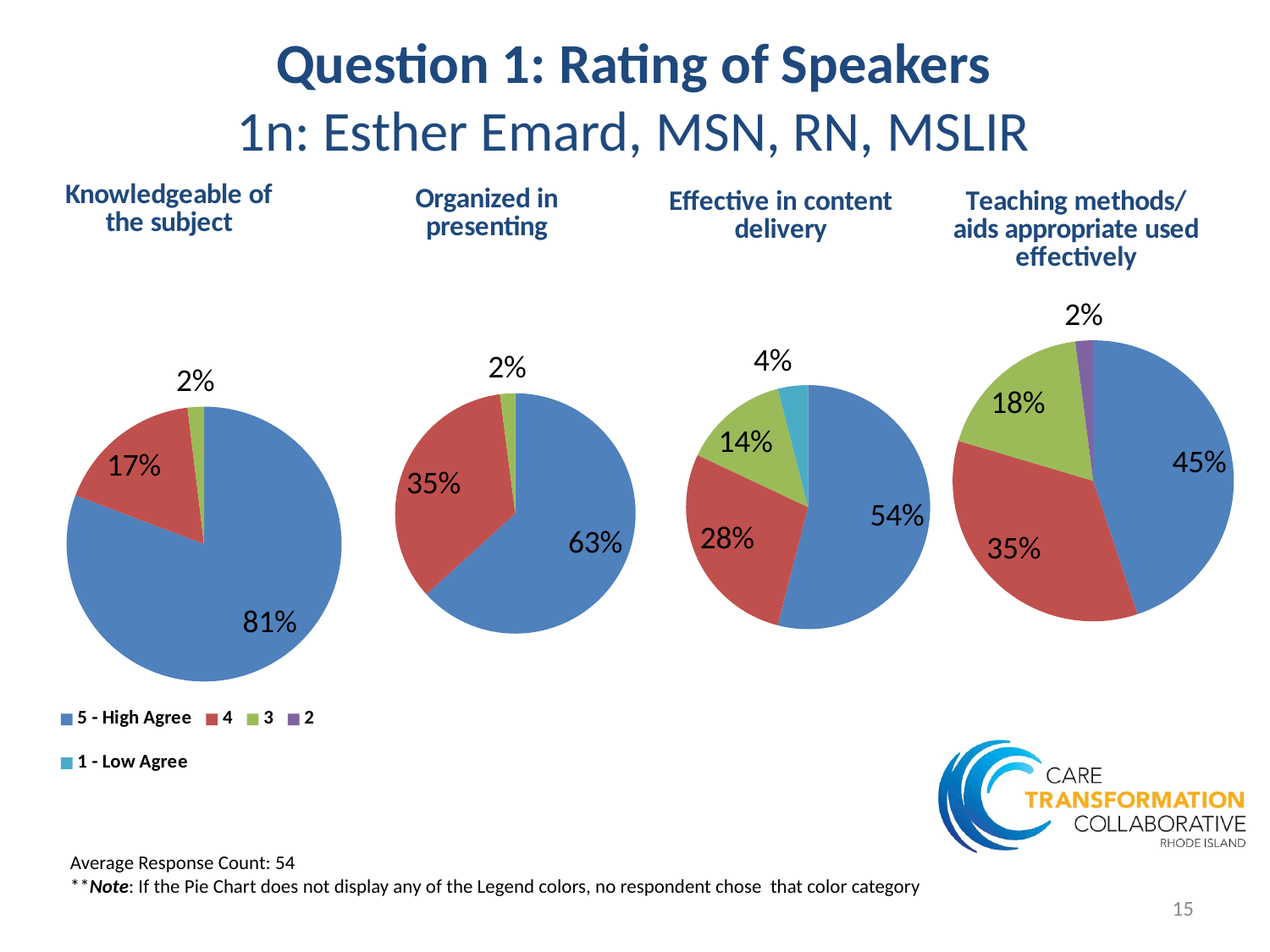
In the 'Teaching methods/aids appropriate used effectively' pie chart, which rating has the largest slice? 5 - High Agree How many slices does the 'Effective in content delivery' pie chart have? 4 In the 'Organized in presenting' pie chart, what percentage is shown for the rating '4'? 35% In the 'Effective in content delivery' pie chart, what percentage is shown for '1 - Low Agree'? 4% What type of chart is used on this slide? Pie chart Is the '5 - High Agree' share larger in the 'Organized in presenting' chart or the 'Effective in content delivery' chart? Organized in presenting In the 'Knowledgeable of the subject' pie chart, what is the difference between the '5 - High Agree' share and the '4' share? 64% In the 'Teaching methods/aids appropriate used effectively' pie chart, what is the combined share of ratings '5 - High Agree' and '4'? 80% In the 'Effective in content delivery' pie chart, which rating has the smallest slice? 1 - Low Agree In the 'Teaching methods/aids appropriate used effectively' pie chart, what percentage is shown for the rating '3'? 18% How many entries does the legend list? 5 In the 'Knowledgeable of the subject' pie chart, what share of respondents chose '5 - High Agree'? 81%